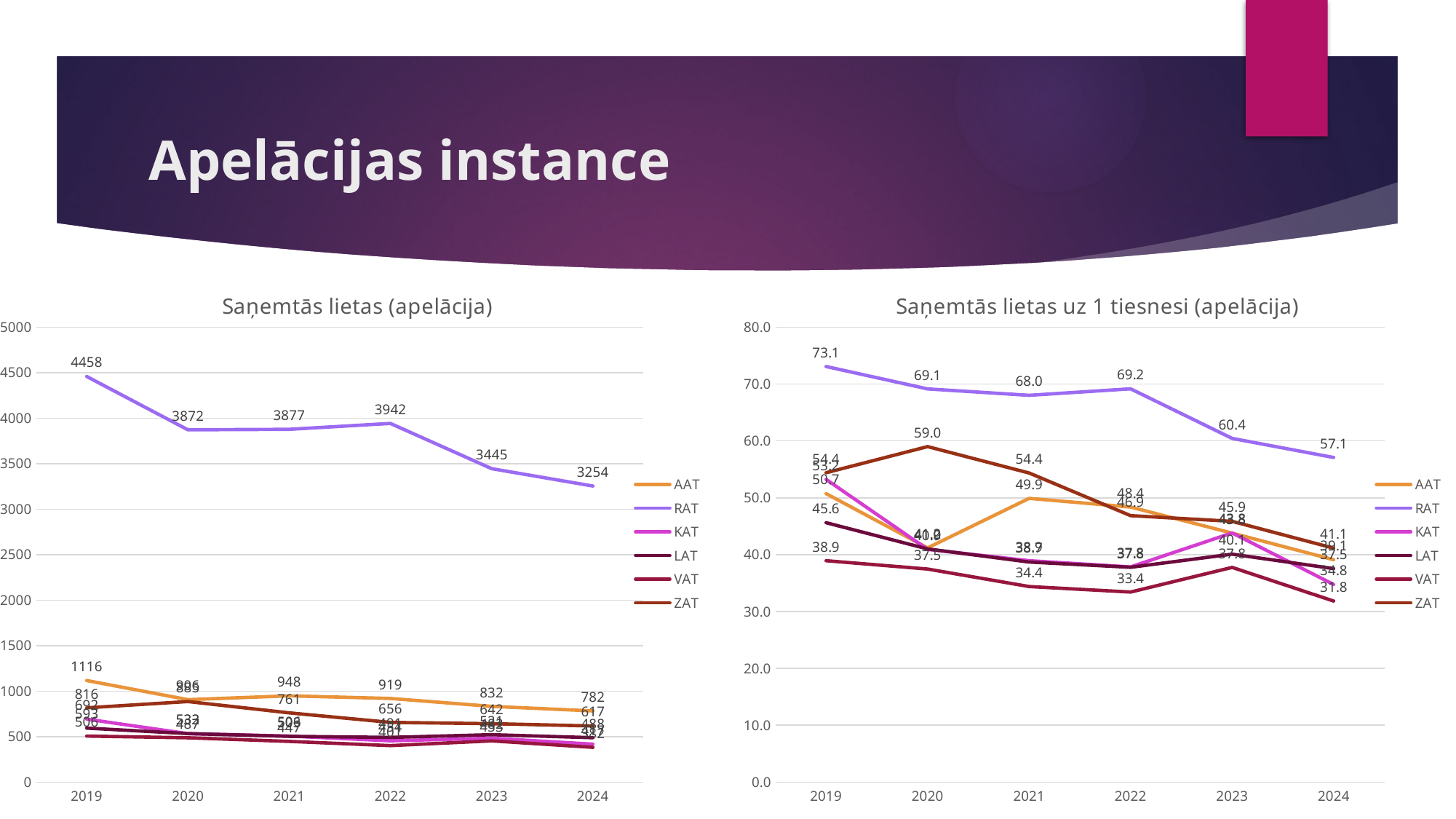
In the chart titled "Saņemtās lietas (apelācija)", which series has the highest value in 2022? RAT In the chart titled "Saņemtās lietas uz 1 tiesnesi (apelācija)", what is the value for VAT in 2022? 33.4 In the chart titled "Saņemtās lietas (apelācija)", what is the difference between the RAT values in 2019 and 2024? 1204 What kind of chart is "Saņemtās lietas uz 1 tiesnesi (apelācija)"? line chart In the chart titled "Saņemtās lietas (apelācija)", what is the value for AAT in 2019? 1116 In the chart titled "Saņemtās lietas uz 1 tiesnesi (apelācija)", what is the value for ZAT in 2020? 59.0 In the chart titled "Saņemtās lietas (apelācija)", how many years are shown on the x axis? 6 In the chart titled "Saņemtās lietas (apelācija)", what is the value for RAT in 2024? 3254 In the chart titled "Saņemtās lietas (apelācija)", what is the value for RAT in 2019? 4458 In the chart titled "Saņemtās lietas (apelācija)", how many series does the legend list? 6 In the chart titled "Saņemtās lietas uz 1 tiesnesi (apelācija)", does the RAT series rise or fall from 2022 to 2024? fall In the chart titled "Saņemtās lietas uz 1 tiesnesi (apelācija)", what is the value for RAT in 2019? 73.1